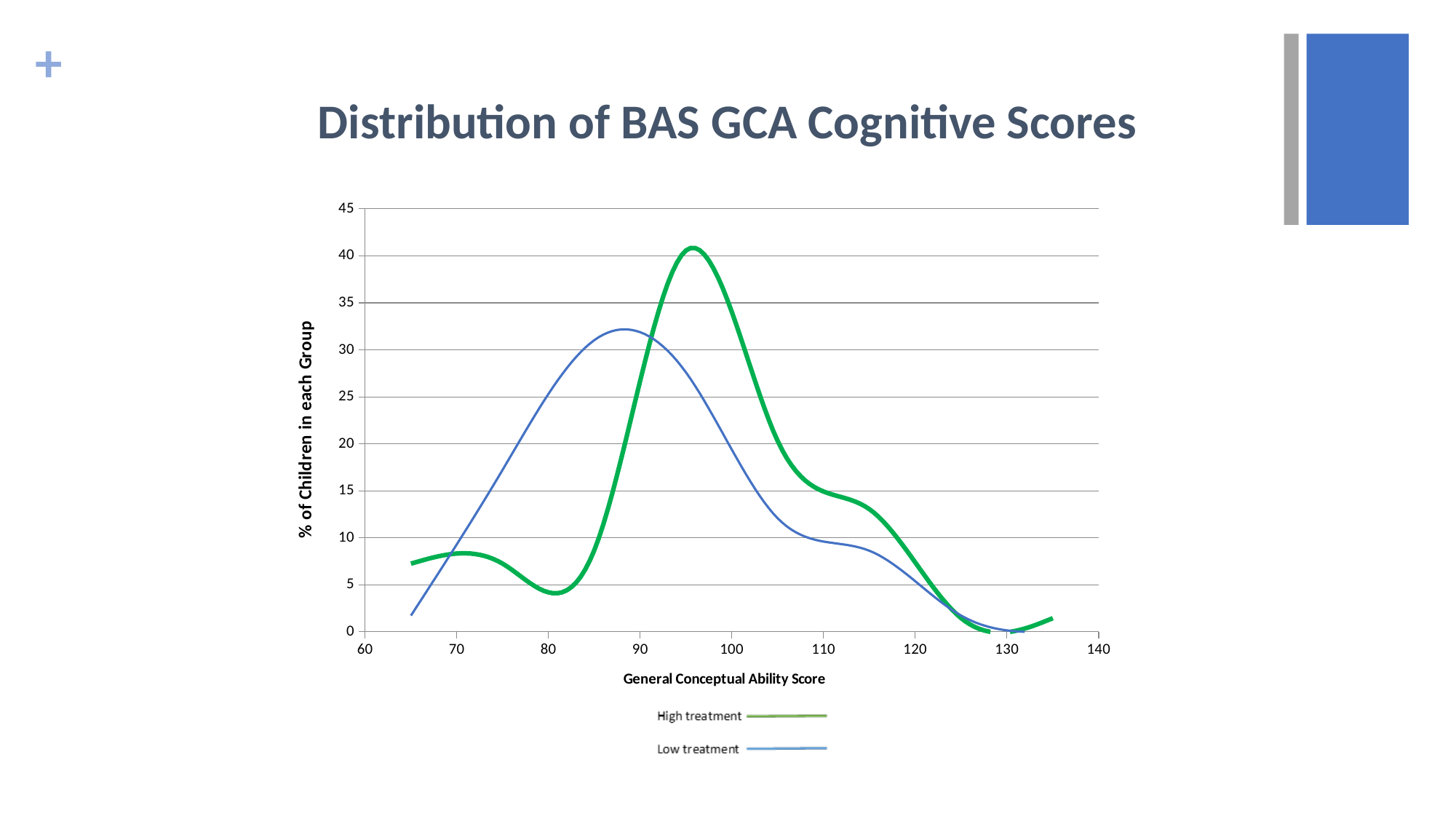
Is the peak value of the High treatment line greater or less than 35? greater Is the value of the High treatment line at a score of 110 greater or less than 10? greater Does the Low treatment line rise or fall between scores of 90 and 120? fall Is the value of the Low treatment line at a score of 110 greater or less than 15? less What is the title of the chart? Distribution of BAS GCA Cognitive Scores What is the label of the vertical axis? % of Children in each Group How many series does the legend list? 2 Which series reaches the higher peak, High treatment or Low treatment? High treatment What kind of chart is shown on the slide? Line chart At a General Conceptual Ability Score of 80, which series has the higher value? Low treatment At a General Conceptual Ability Score of 100, which series has the higher value? High treatment